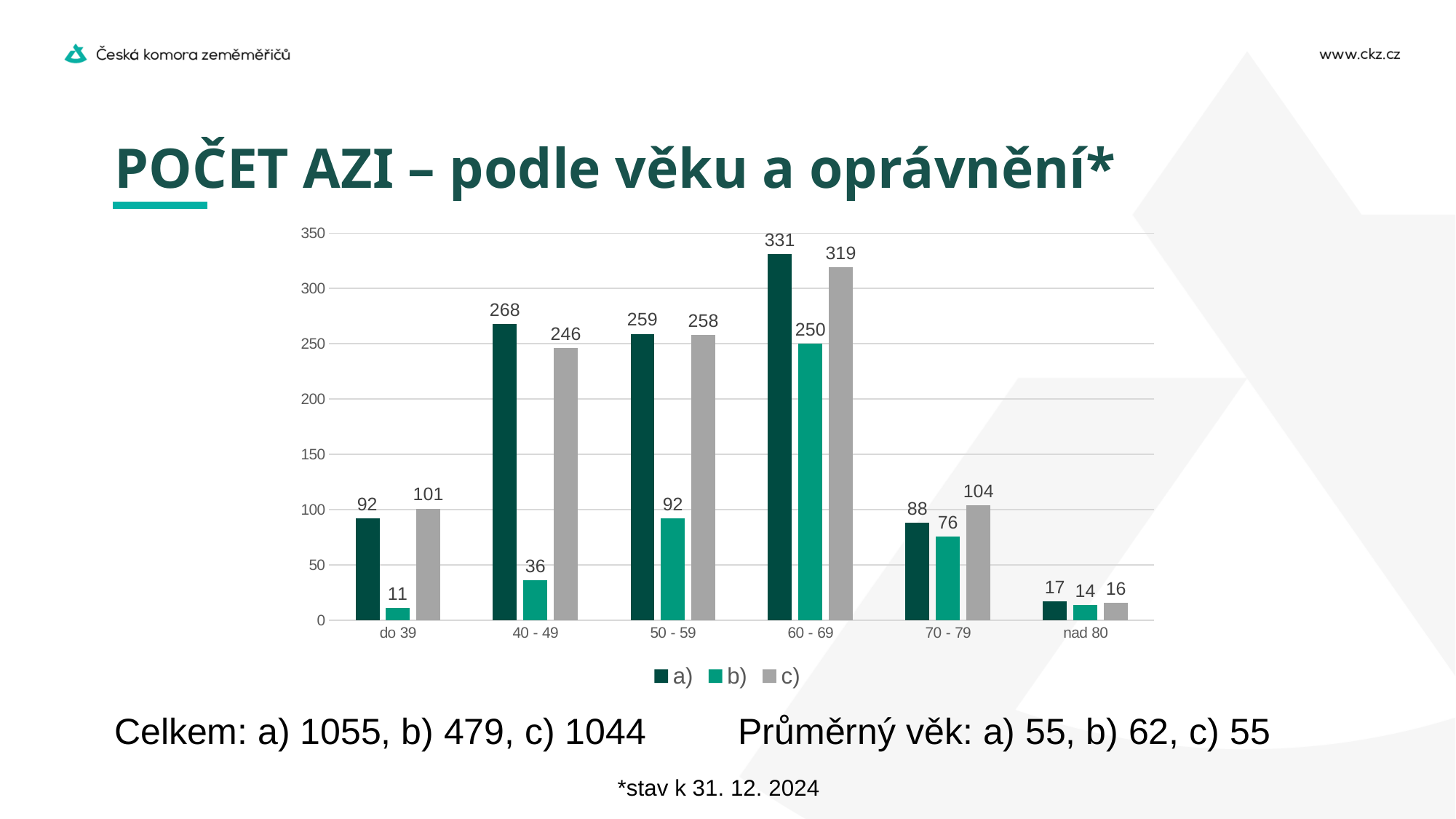
What kind of chart is shown on the slide? bar chart How many series does the legend list? 3 What is the title of the slide containing the chart? POČET AZI – podle věku a oprávnění* Which is larger in the 70 - 79 age group: series a) or series c)? c) Is the value for series b) in the 60 - 69 age group greater or less than 200? greater Which age group has the highest value for series c)? 60 - 69 What is the value for series b) in the 40 - 49 age group? 36 What is the value for series a) in the 60 - 69 age group? 331 Which age group has the lowest value for series a)? nad 80 What is the value for series c) in the do 39 age group? 101 What is the difference between series a) and series b) in the 50 - 59 age group? 167 How many age groups are shown on the x axis? 6